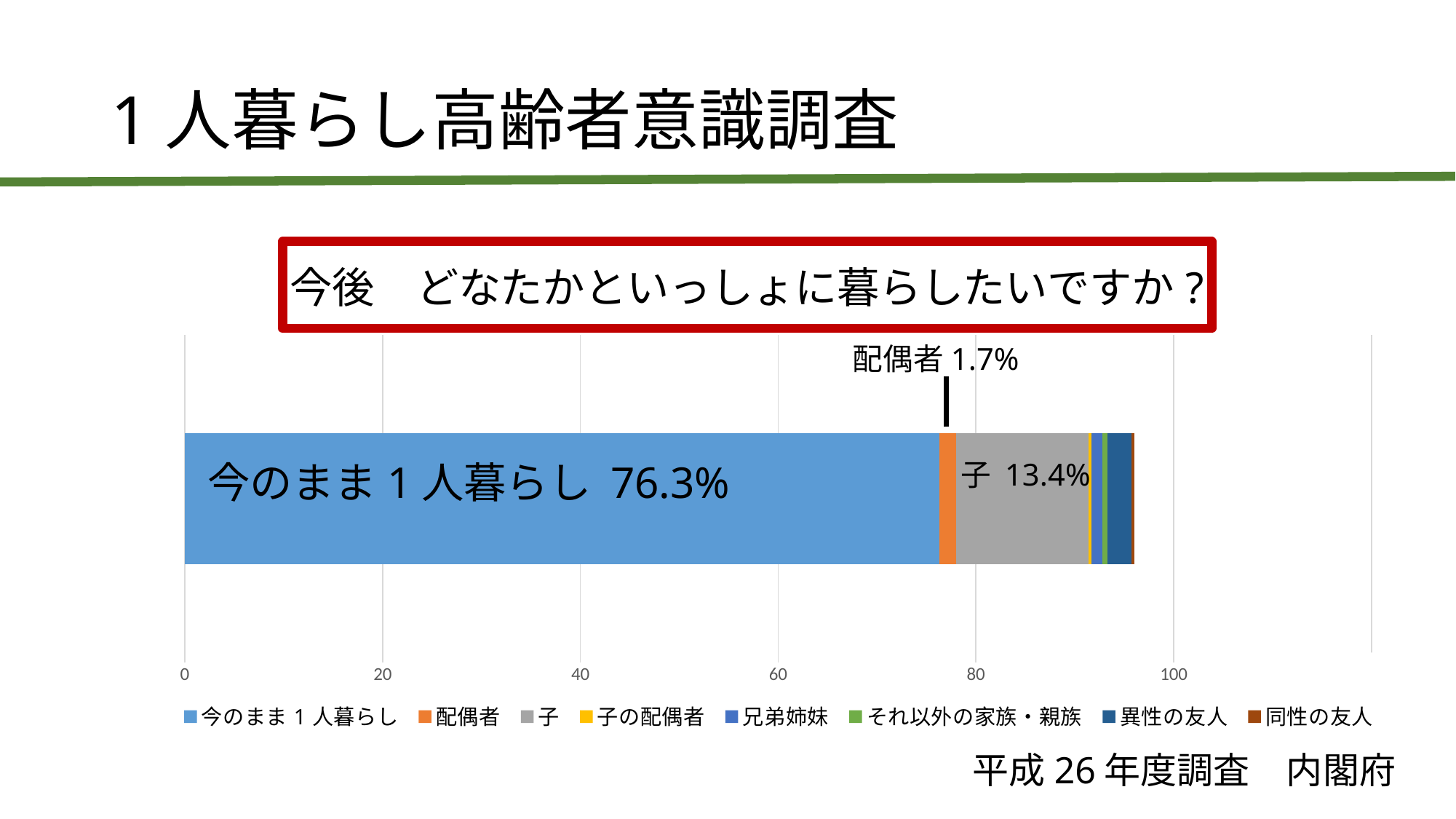
What percentage is shown for 配偶者? 1.7% Which is larger, the value for 子 or the value for 配偶者? 子 What percentage is shown for 子? 13.4% What percentage is shown for 今のまま１人暮らし? 76.3% What is the difference between the values for 今のまま１人暮らし and 子? 62.9 percentage points How many series does the legend list? 8 What question is written in the red box above the chart? 今後 どなたかといっしょに暮らしたいですか？ Does the full stacked bar end at a value greater or less than 100 on the axis? less Is the value for 今のまま１人暮らし greater or less than 60? greater What is the difference between the values for 子 and 配偶者? 11.7 percentage points What kind of chart is shown on the slide? Stacked bar chart Which segment of the bar is the largest? 今のまま１人暮らし